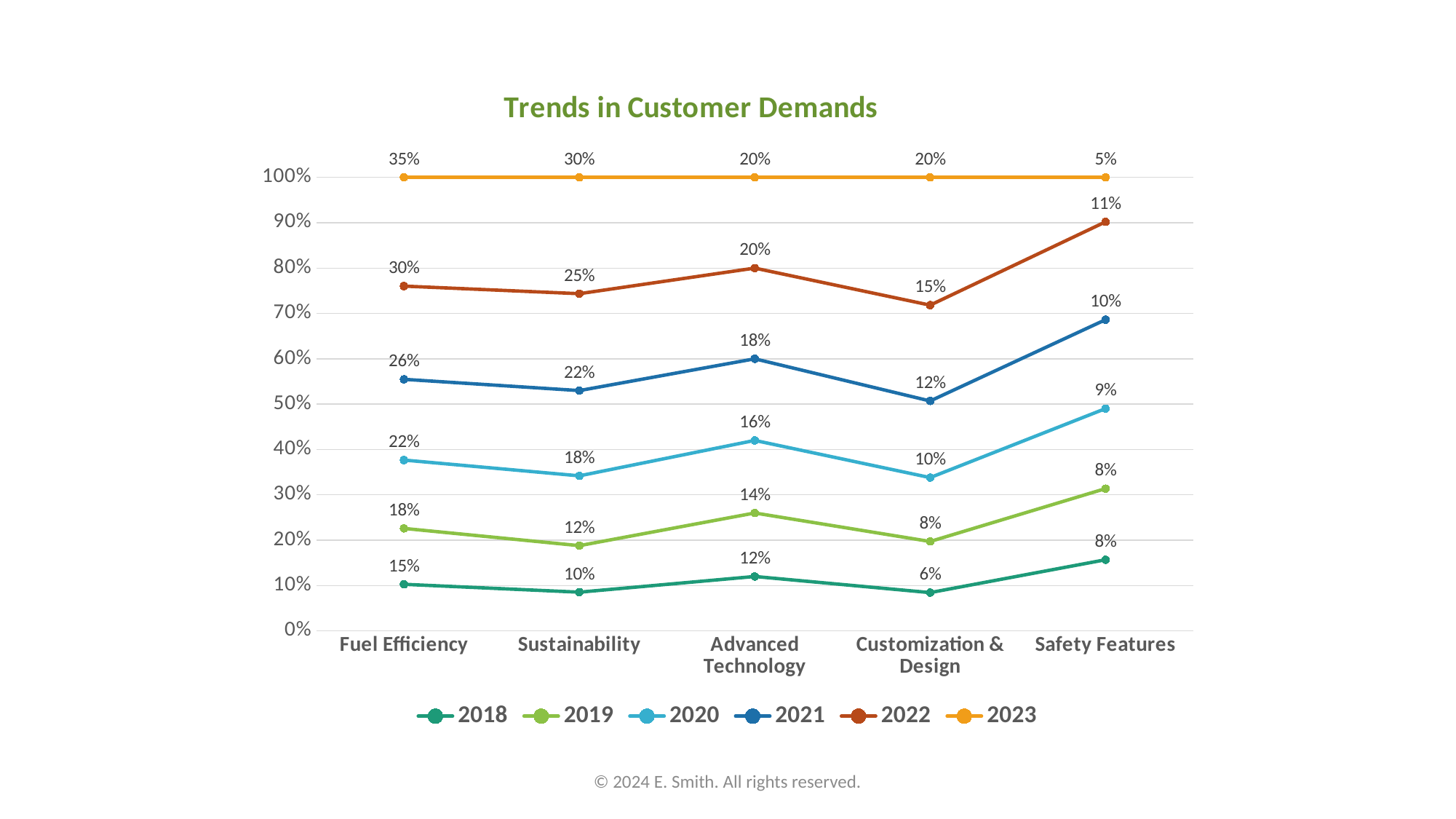
What is the 2021 value for Advanced Technology? 18% What is the difference between the 2023 and 2018 values for Fuel Efficiency? 20% What is the title of the chart? Trends in Customer Demands Which is larger for Sustainability: the 2019 value or the 2020 value? 2020 How many categories are shown on the x axis? 5 What is the 2018 value for Fuel Efficiency? 15% What is the 2020 value for Customization & Design? 10% Which category has the lowest 2018 value? Customization & Design What kind of chart is shown on the slide? Line chart Which category has the highest 2022 value? Fuel Efficiency How many series does the legend list? 6 What is the 2023 value for Safety Features? 5%